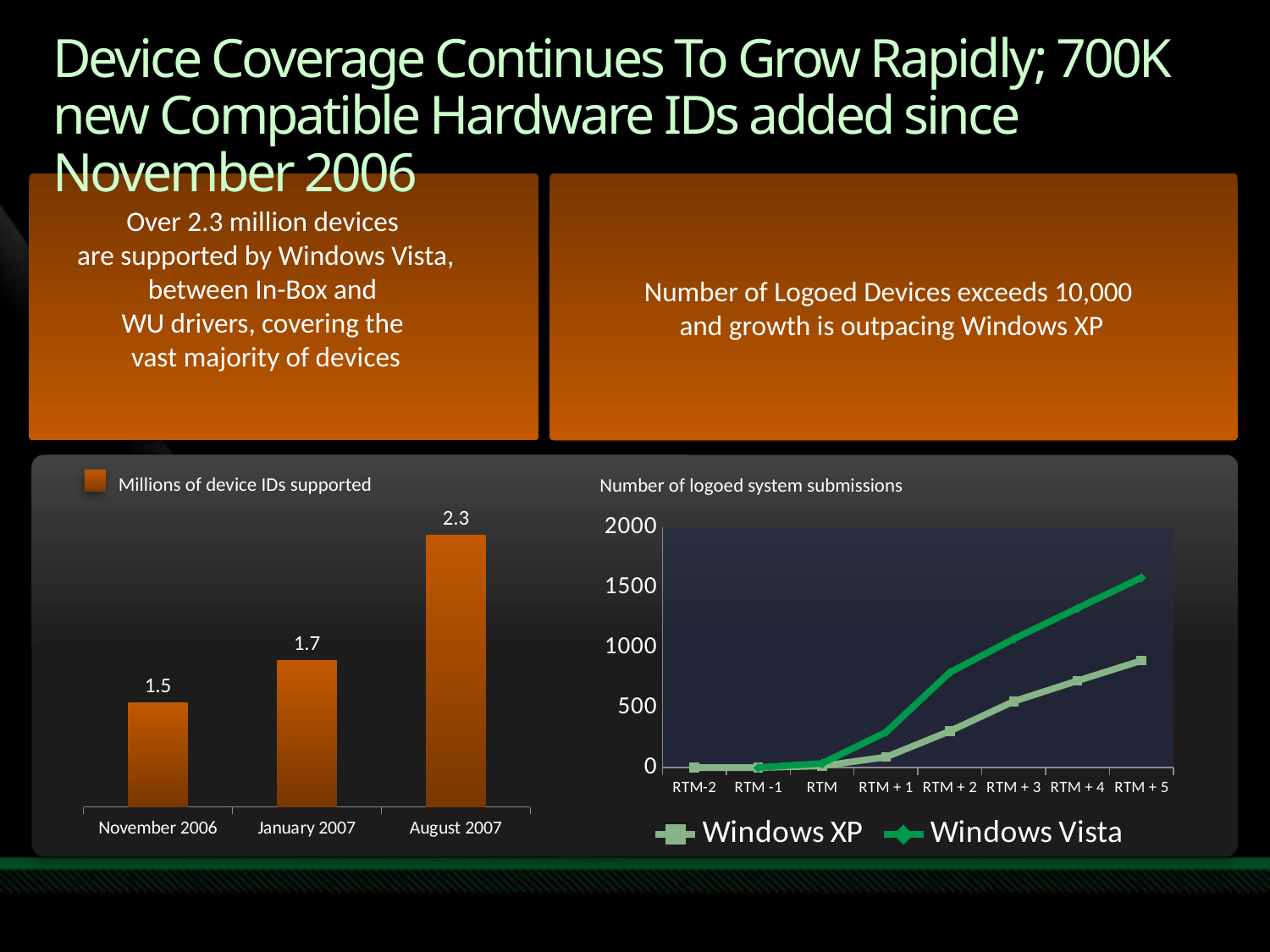
In the 'Number of logoed system submissions' chart, is the Windows Vista value at RTM + 5 greater or less than 1000? greater In the 'Millions of device IDs supported' chart, what is the value for August 2007? 2.3 In the 'Number of logoed system submissions' chart, do the Windows Vista values rise or fall from RTM to RTM + 5? rise In the 'Millions of device IDs supported' chart, which category has the highest value? August 2007 In the 'Millions of device IDs supported' chart, what is the difference between the August 2007 and November 2006 values? 0.8 In the 'Millions of device IDs supported' chart, which category has the lowest value? November 2006 In the 'Millions of device IDs supported' chart, how many categories are shown? 3 What kind of chart is the 'Millions of device IDs supported' chart? bar chart In the 'Number of logoed system submissions' chart, how many series does the legend list? 2 In the 'Number of logoed system submissions' chart, is the Windows XP value at RTM + 5 greater or less than 1000? less In the 'Number of logoed system submissions' chart, which series is higher at RTM + 4, Windows XP or Windows Vista? Windows Vista In the 'Millions of device IDs supported' chart, what is the value for November 2006? 1.5